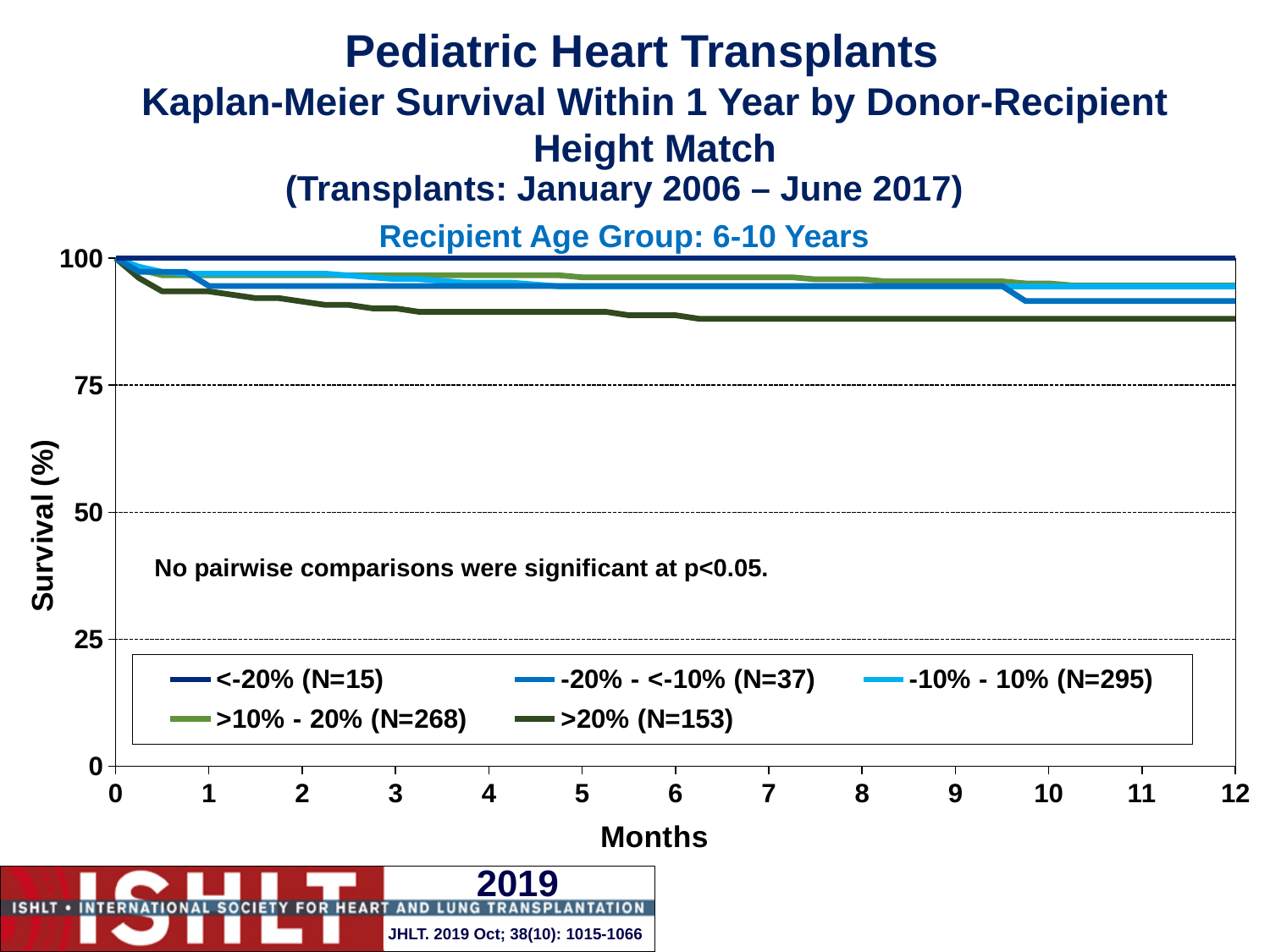
How many series does the legend list? 5 At 12 months, which has higher survival: the <-20% (N=15) group or the >20% (N=153) group? <-20% (N=15) Which height match group has the lowest survival at 12 months? >20% (N=153) What kind of chart is shown on the slide? line chart Do the survival curves rise or fall as months increase along the x axis? fall Which height match group has the highest survival at 12 months? <-20% (N=15) Is the survival for the >20% (N=153) group at 12 months greater or less than 75? greater What is the N shown in the legend for the -10% - 10% height match group? 295 Which recipient age group does the chart cover, according to the subtitle? 6-10 Years Is the survival for the -20% - <-10% (N=37) group at 12 months greater or less than 75? greater How many month tick marks are labelled on the x axis? 13 Is the survival for the >10% - 20% (N=268) group at 6 months greater or less than 50? greater